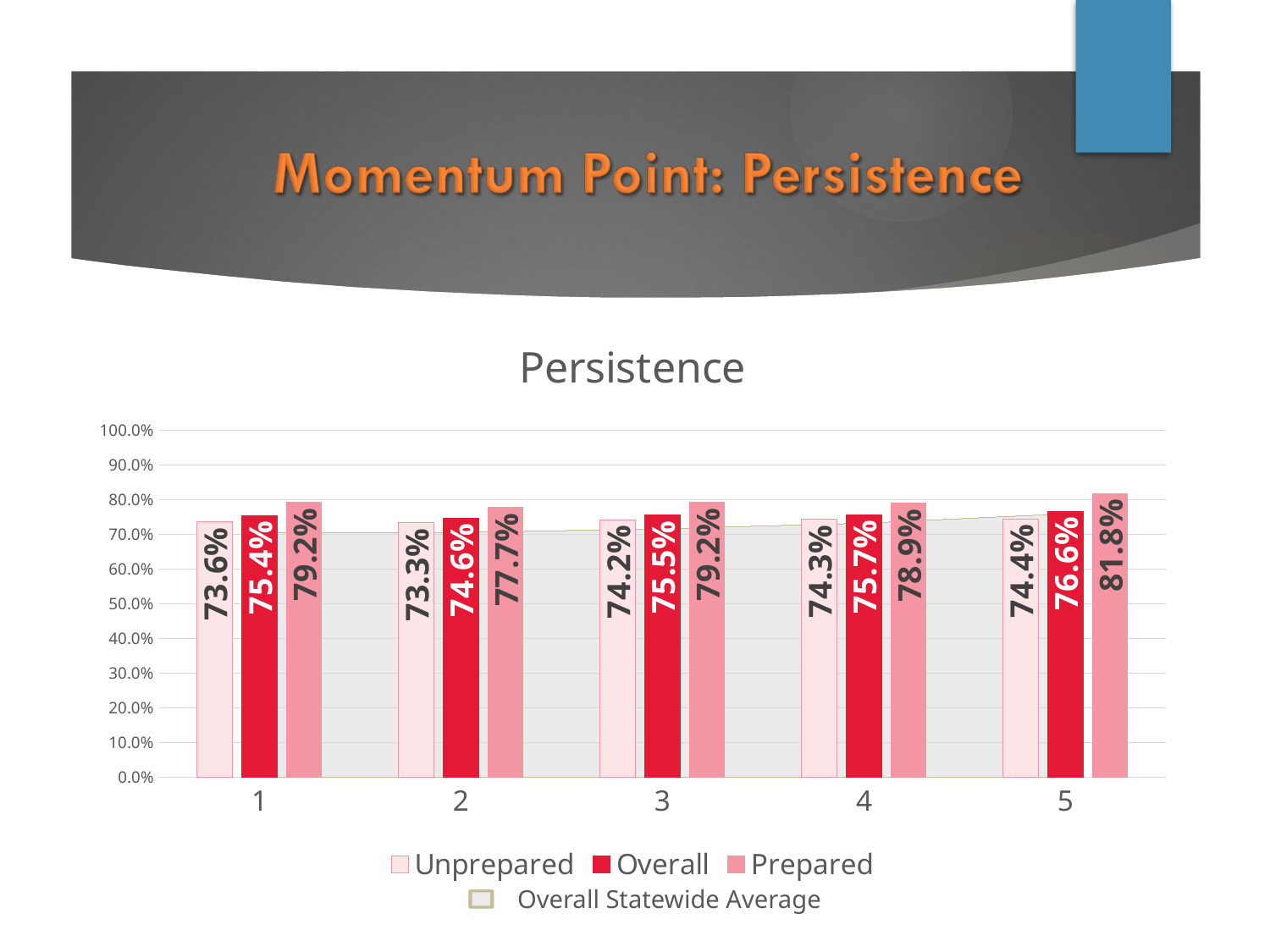
What is the difference between the Prepared and Unprepared values for category 5? 7.4% What kind of chart is used to show the Unprepared, Overall and Prepared values? bar chart Which is larger for category 4: the Overall value or the Prepared value? Prepared How many series does the legend list? 4 Do the Overall values rise or fall from category 3 to category 5? rise Which category has the lowest Unprepared value? 2 What is the Prepared value for category 5? 81.8% Which category has the highest Prepared value? 5 How many categories are shown on the x axis? 5 What is the Unprepared value for category 2? 73.3% What is the Overall value for category 3? 75.5% Is the Prepared value for category 1 greater or less than 70.0%? greater